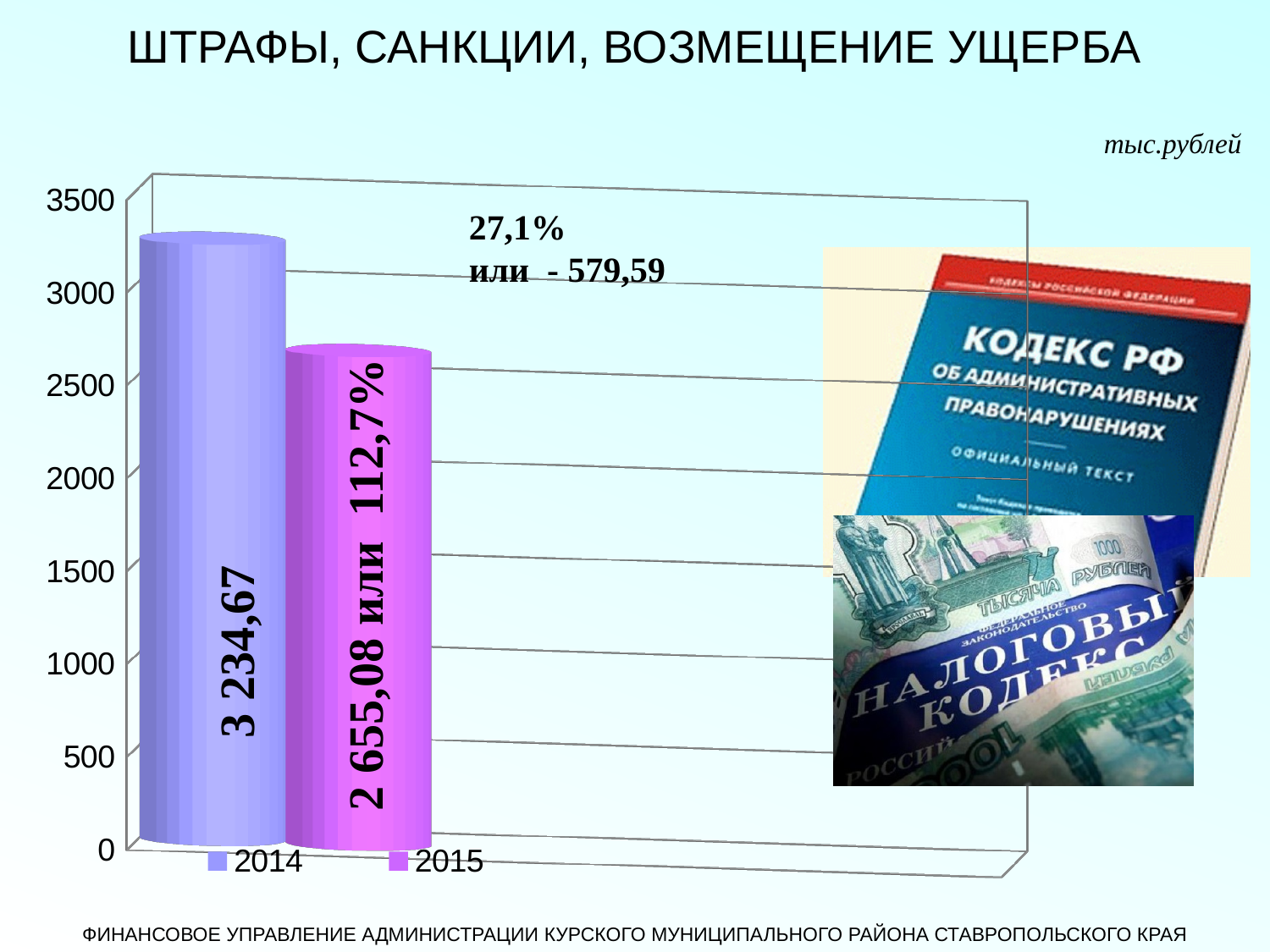
What unit of measurement is stated for the chart? тыс.рублей Is the value for 2015 larger or smaller than the value for 2014? smaller Which year has the lower value? 2015 What kind of chart is shown on the slide? bar chart What is the value for 2014? 3 234,67 What is the value for 2015? 2 655,08 Which year has the higher value? 2014 Is the value for 2015 greater or less than 3000? less Is the value for 2014 greater or less than 3000? greater What is the difference between the 2014 and 2015 values? 579,59 How many bars are plotted on the chart? 2 How many entries does the legend list? 2